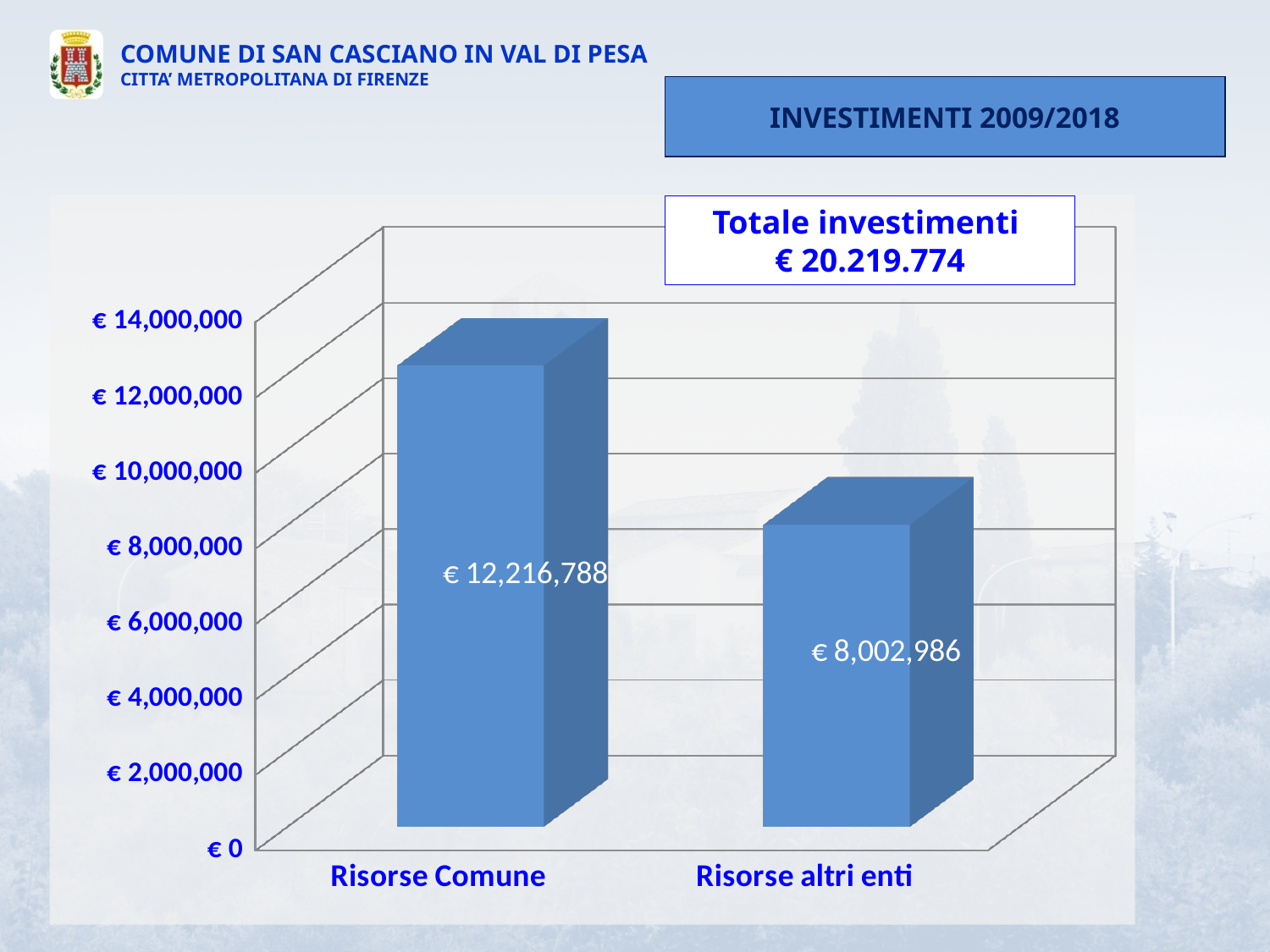
What total investment amount is stated in the box above the chart? € 20.219.774 How many categories are shown on the chart? 2 What is the value for Risorse altri enti? € 8,002,986 Is the value for Risorse Comune greater or less than € 12,000,000? greater What is the value for Risorse Comune? € 12,216,788 Which category has the lowest value? Risorse altri enti Which category has the highest value? Risorse Comune What is the difference between the values for Risorse Comune and Risorse altri enti? € 4,213,802 Is the value for Risorse altri enti greater or less than € 10,000,000? less Which is larger, the value for Risorse Comune or the value for Risorse altri enti? Risorse Comune What is the highest value shown on the vertical axis? € 14,000,000 What kind of chart is shown on the slide? bar chart